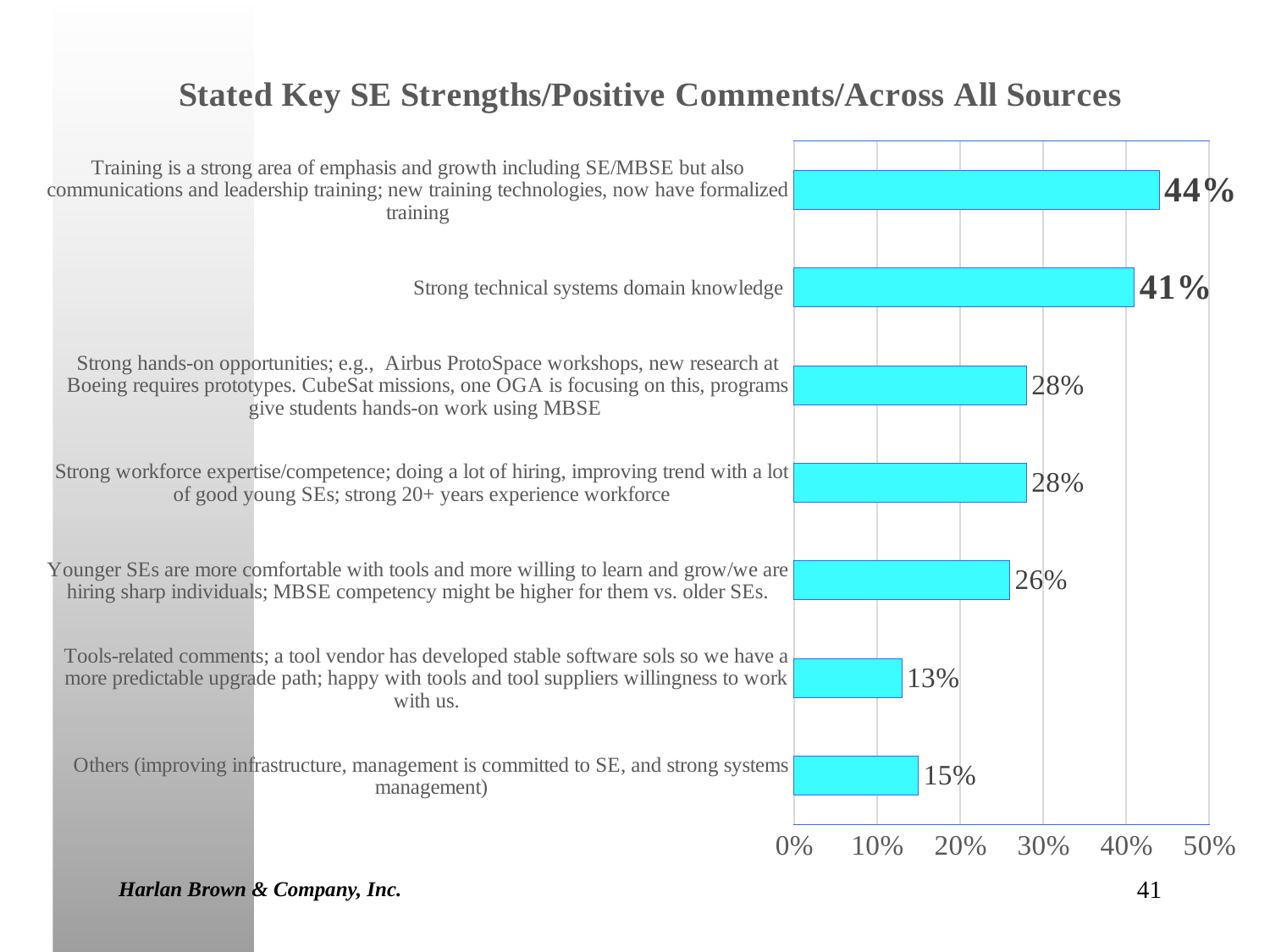
What is the maximum value shown on the horizontal axis? 50% What is the value for "Strong technical systems domain knowledge"? 41% Which category has the highest value? Training is a strong area of emphasis and growth including SE/MBSE but also communications and leadership training; new training technologies, now have formalized training Is the value for "Younger SEs are more comfortable with tools..." greater or less than 20%? greater What is the value for the "Others (improving infrastructure, management is committed to SE, and strong systems management)" category? 15% Which is larger: the value for "Others" or the value for "Tools-related comments"? Others What is the title of the chart? Stated Key SE Strengths/Positive Comments/Across All Sources What is the difference between the value for the training category (44%) and the value for "Strong technical systems domain knowledge" (41%)? 3% What is the value for the "Tools-related comments" category? 13% Which category has the lowest value? Tools-related comments; a tool vendor has developed stable software sols so we have a more predictable upgrade path; happy with tools and tool suppliers willingness to work with us. How many categories are shown in the chart? 7 What kind of chart is shown on the slide? Bar chart